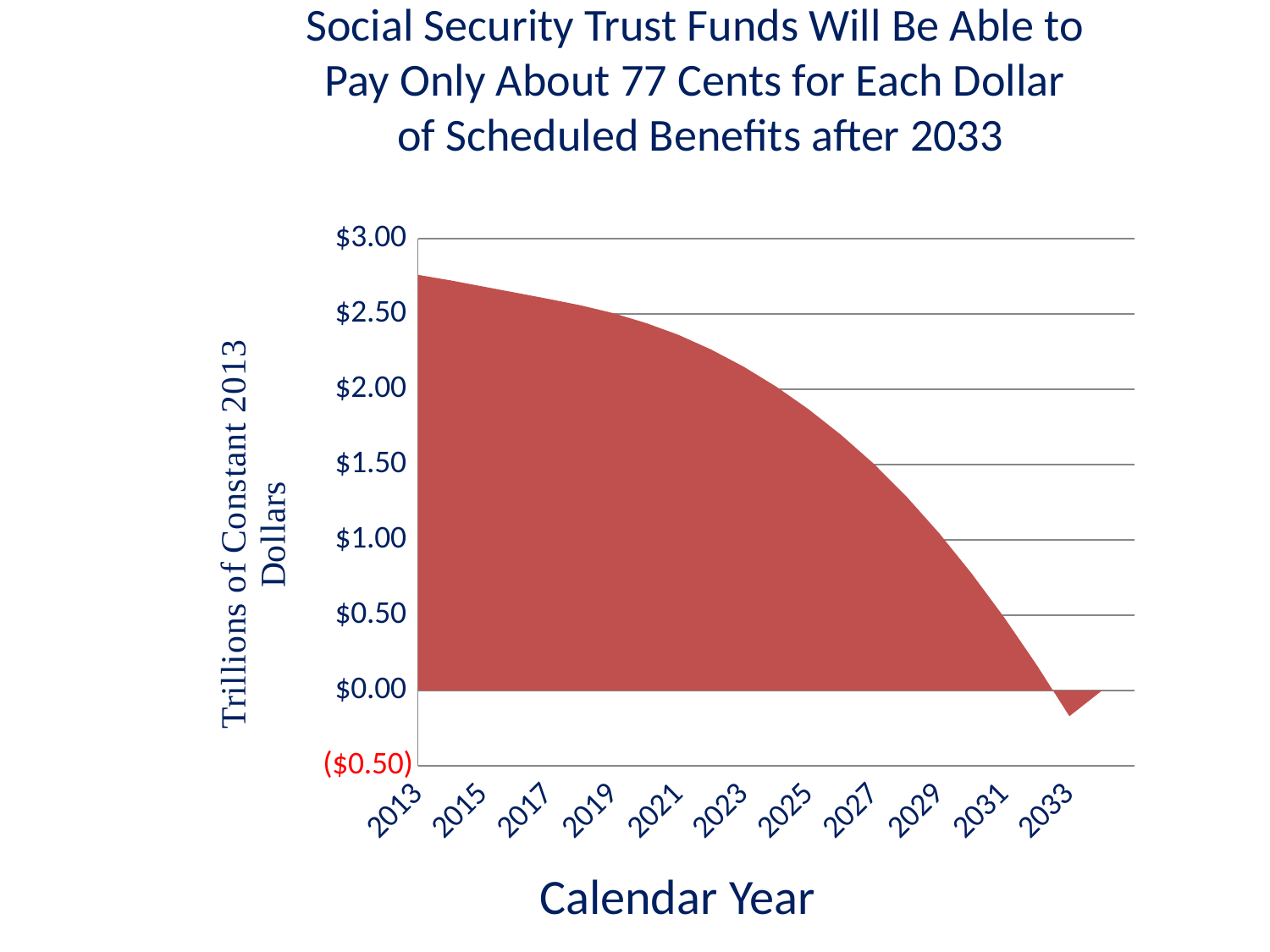
What is the title of the x axis? Calendar Year Is the value for 2027 greater or less than $2.00? less How many year labels are shown on the x axis? 11 Is the value for 2013 greater or less than $2.50? greater What kind of chart is shown on the slide? area chart Do the values rise or fall as the calendar year increases from 2013 to 2033? fall What is the title of the y axis? Trillions of Constant 2013 Dollars Is the value for 2025 greater or less than $2.00? less Which year has the larger value, 2017 or 2031? 2017 Which labeled year has the highest value on the chart? 2013